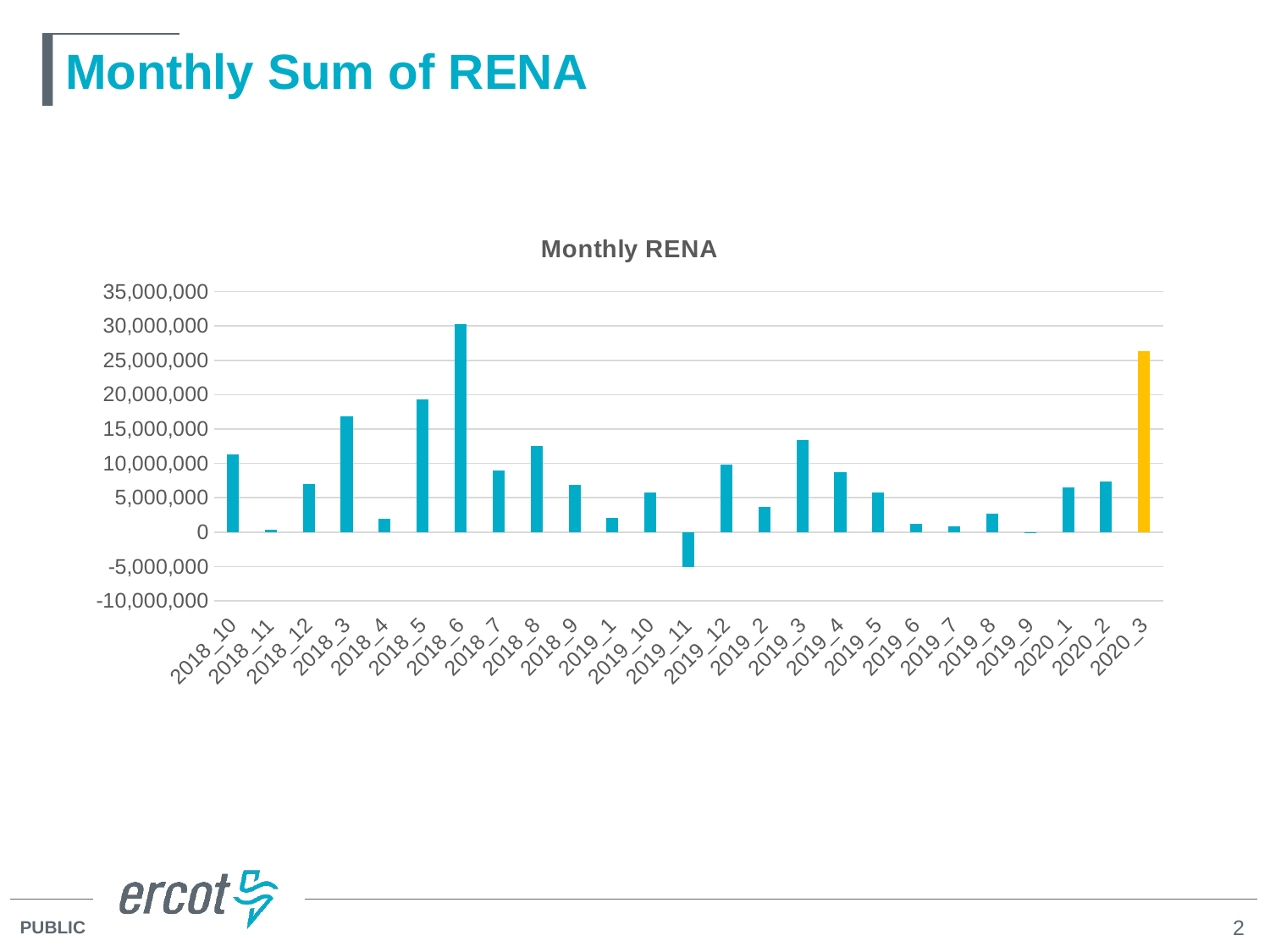
Which month has the highest Monthly RENA value? 2018_6 Which bar is shown in a different colour (yellow) from the rest? 2020_3 How many monthly categories are plotted on the x axis? 25 Is the value for 2019_11 greater or less than 0? less Is the value for 2019_6 greater or less than 5,000,000? less Is the value for 2018_6 greater or less than 25,000,000? greater What kind of chart is shown on the slide? bar chart Which month has the lowest Monthly RENA value? 2019_11 What is the title of the chart? Monthly RENA Which is larger, the value for 2018_6 or the value for 2020_3? 2018_6 Which is larger, the value for 2018_3 or the value for 2019_3? 2018_3